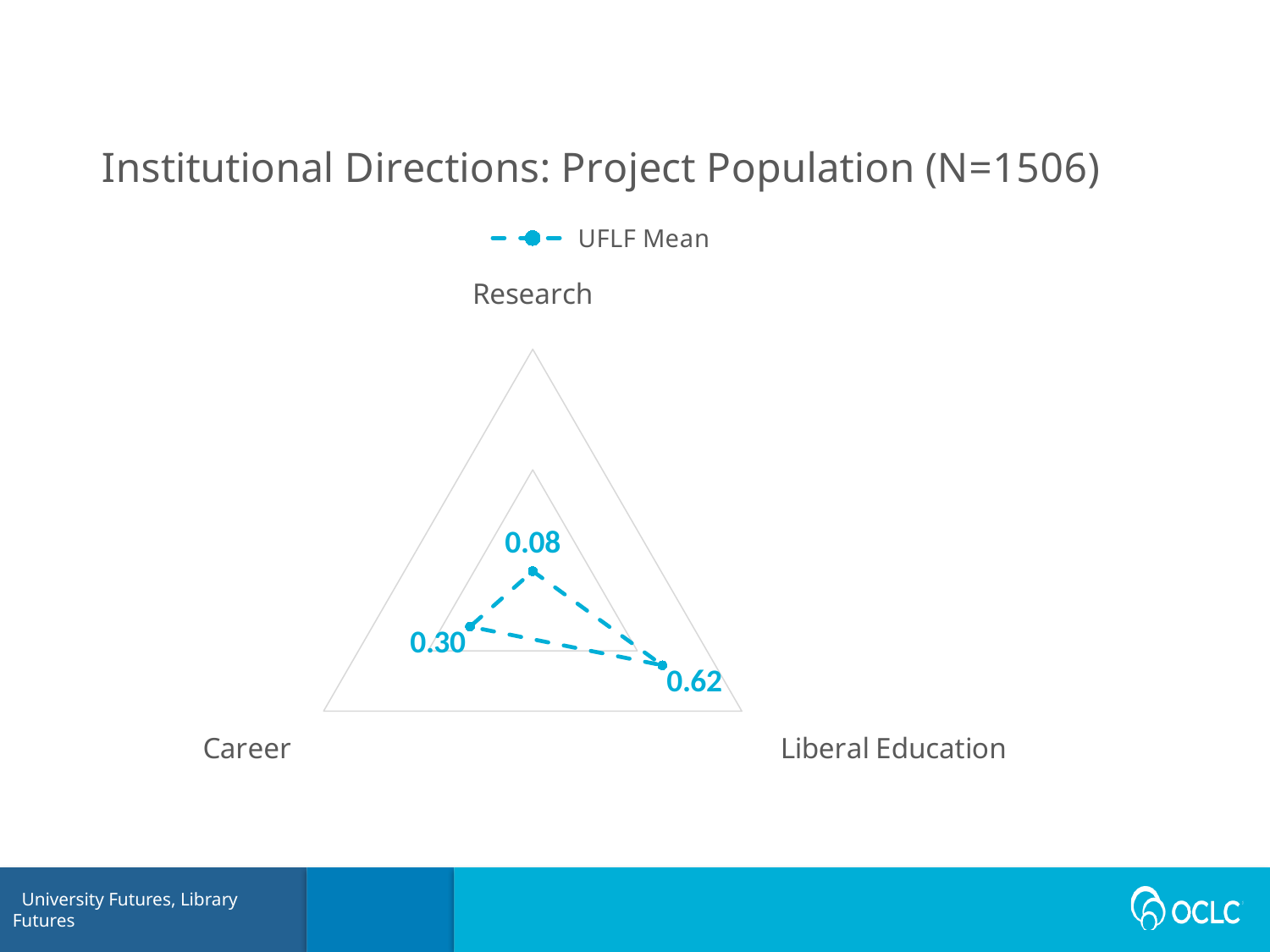
How many series does the legend list? 1 What is the UFLF Mean value for Liberal Education? 0.62 What is the UFLF Mean value for Research? 0.08 What is the UFLF Mean value for Career? 0.30 How many categories (axes) does the radar chart have? 3 What is the title of the chart? Institutional Directions: Project Population (N=1506) What is the difference between the UFLF Mean values for Career and Research? 0.22 Which is larger, the UFLF Mean value for Career or for Research? Career What kind of chart is shown on the slide? Radar chart Which category has the highest UFLF Mean value? Liberal Education Which category has the lowest UFLF Mean value? Research What is the difference between the UFLF Mean values for Liberal Education and Career? 0.32